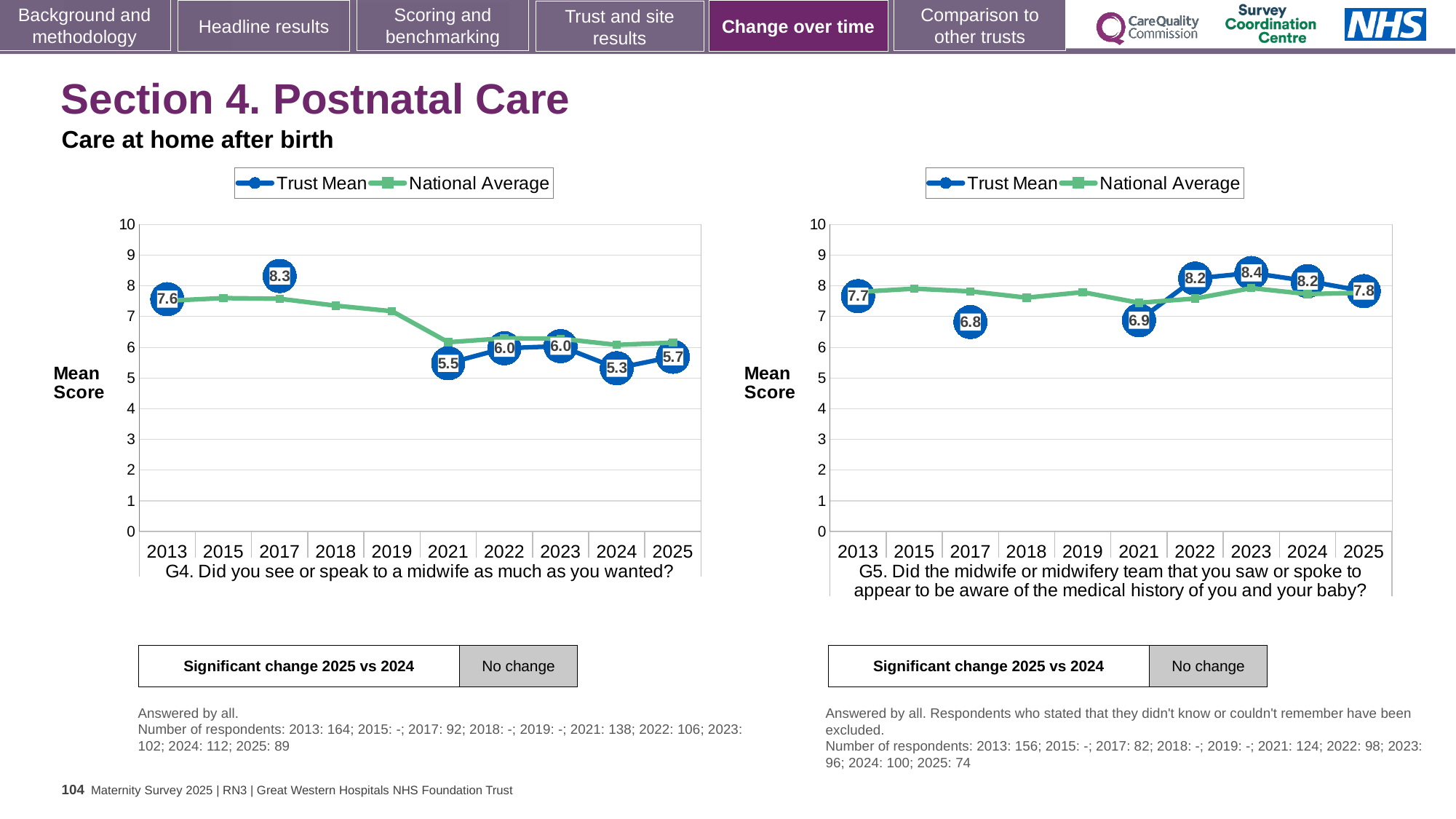
How many series does the legend of the left chart (G4) list? 2 In the left chart (G4), what is the Trust Mean for 2024? 5.3 In the left chart (G4), which year has the highest labelled Trust Mean? 2017 In the right chart (G5), what is the Trust Mean for 2023? 8.4 How many years are shown on the x axis of the right chart (G5)? 10 In the left chart (G4), what is the difference between the Trust Mean in 2017 and in 2024? 3.0 In the right chart (G5), which year has the lowest labelled Trust Mean? 2017 In the left chart (G4), what is the Trust Mean for 2017? 8.3 In the right chart (G5), what is the Trust Mean for 2025? 7.8 In the right chart (G5), which is larger, the Trust Mean for 2013 or for 2021? 2013 What type of chart is used for the G5 question on the right? Line chart In the left chart (G4), is the National Average for 2019 greater or less than 6? greater